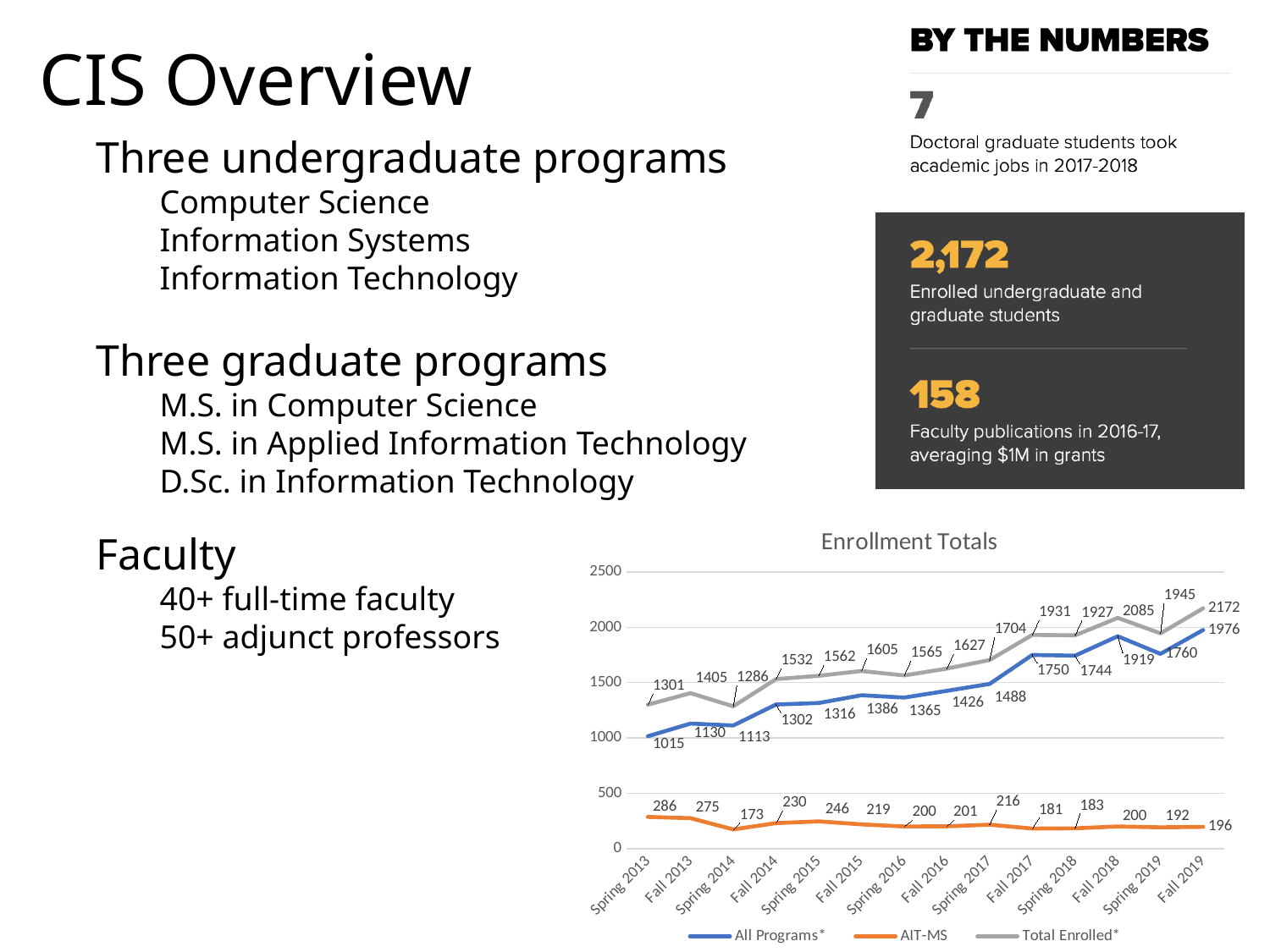
What is the AIT-MS value for Spring 2014 in the Enrollment Totals chart? 173 In which period is the AIT-MS series highest in the Enrollment Totals chart? Spring 2013 In which period is the Total Enrolled series lowest in the Enrollment Totals chart? Spring 2014 What is the All Programs value for Spring 2013 in the Enrollment Totals chart? 1015 Which is larger in the Enrollment Totals chart: the All Programs value for Fall 2018 or for Spring 2019? Fall 2018 What colour is the AIT-MS line in the Enrollment Totals chart? orange Overall, does the Total Enrolled series rise or fall from Spring 2013 to Fall 2019 in the Enrollment Totals chart? rise How many series does the legend of the Enrollment Totals chart list? 3 How many time periods are shown on the x axis of the Enrollment Totals chart? 14 What kind of chart is the Enrollment Totals chart? line chart What is the difference between the Total Enrolled and All Programs values for Fall 2019 in the Enrollment Totals chart? 196 What is the Total Enrolled value for Fall 2019 in the Enrollment Totals chart? 2172